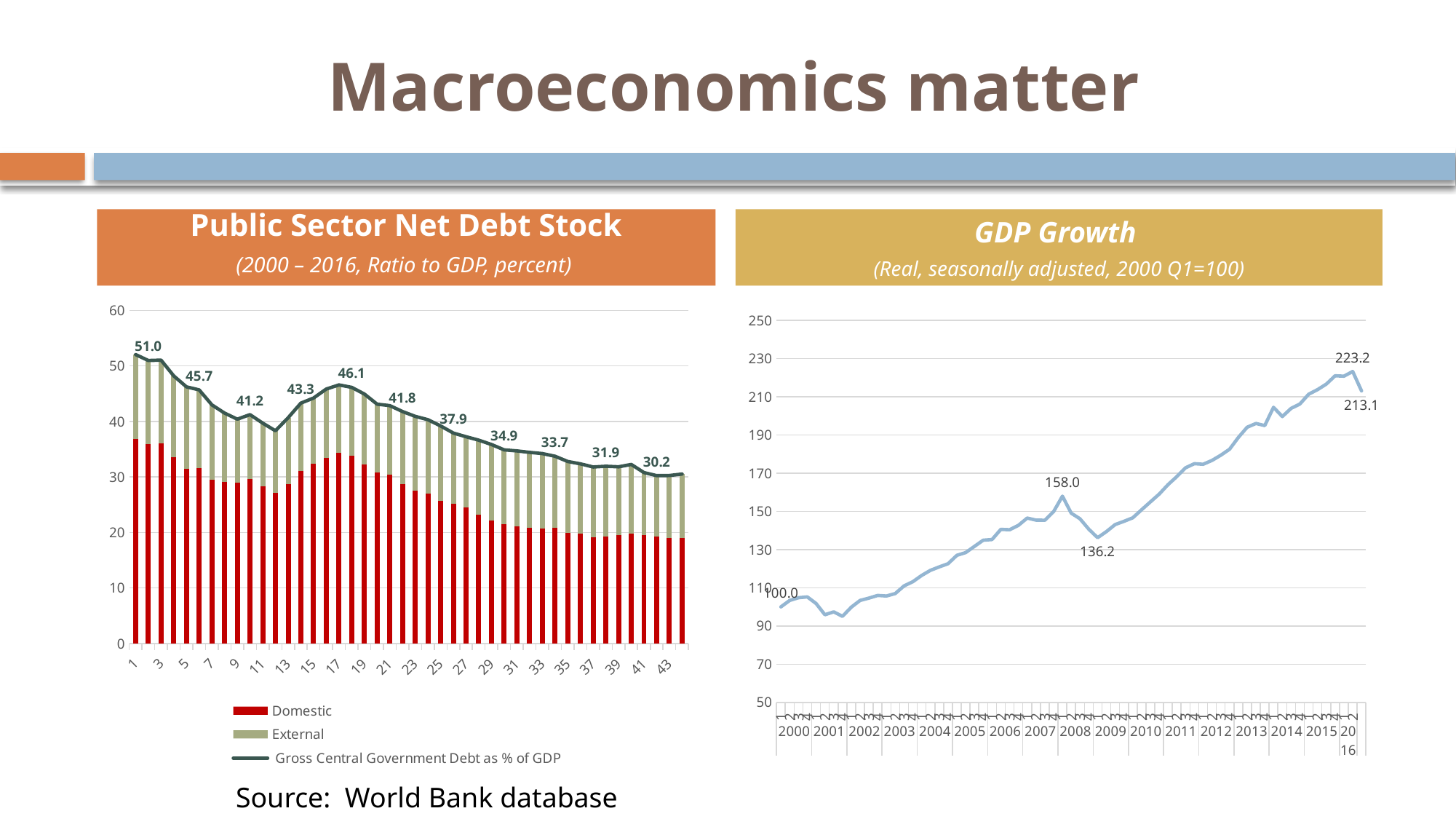
In the Public Sector Net Debt Stock chart, what colour represents the Domestic series? Red In the Public Sector Net Debt Stock chart, what is the highest labelled value on the Gross Central Government Debt as % of GDP line? 51.0 In the Public Sector Net Debt Stock chart, what is the lowest labelled value on the Gross Central Government Debt as % of GDP line? 30.2 In the GDP Growth chart, do the values generally rise or fall from 2000 to 2016? Rise In the GDP Growth chart, what is the difference between the labelled values 223.2 and 213.1? 10.1 In the GDP Growth chart, what is the labelled value at the 2008 peak before the decline? 158.0 In the GDP Growth chart, is the value during 2001 greater or less than 110? less How many series does the legend of the Public Sector Net Debt Stock chart list? 3 In the Public Sector Net Debt Stock chart, which labelled line value is larger, 43.3 or 46.1? 46.1 In the Public Sector Net Debt Stock chart, what is the difference between the highest labelled value (51.0) and the lowest labelled value (30.2) on the line? 20.8 What kind of chart is the GDP Growth chart? Line chart In the GDP Growth chart, what is the highest labelled value? 223.2